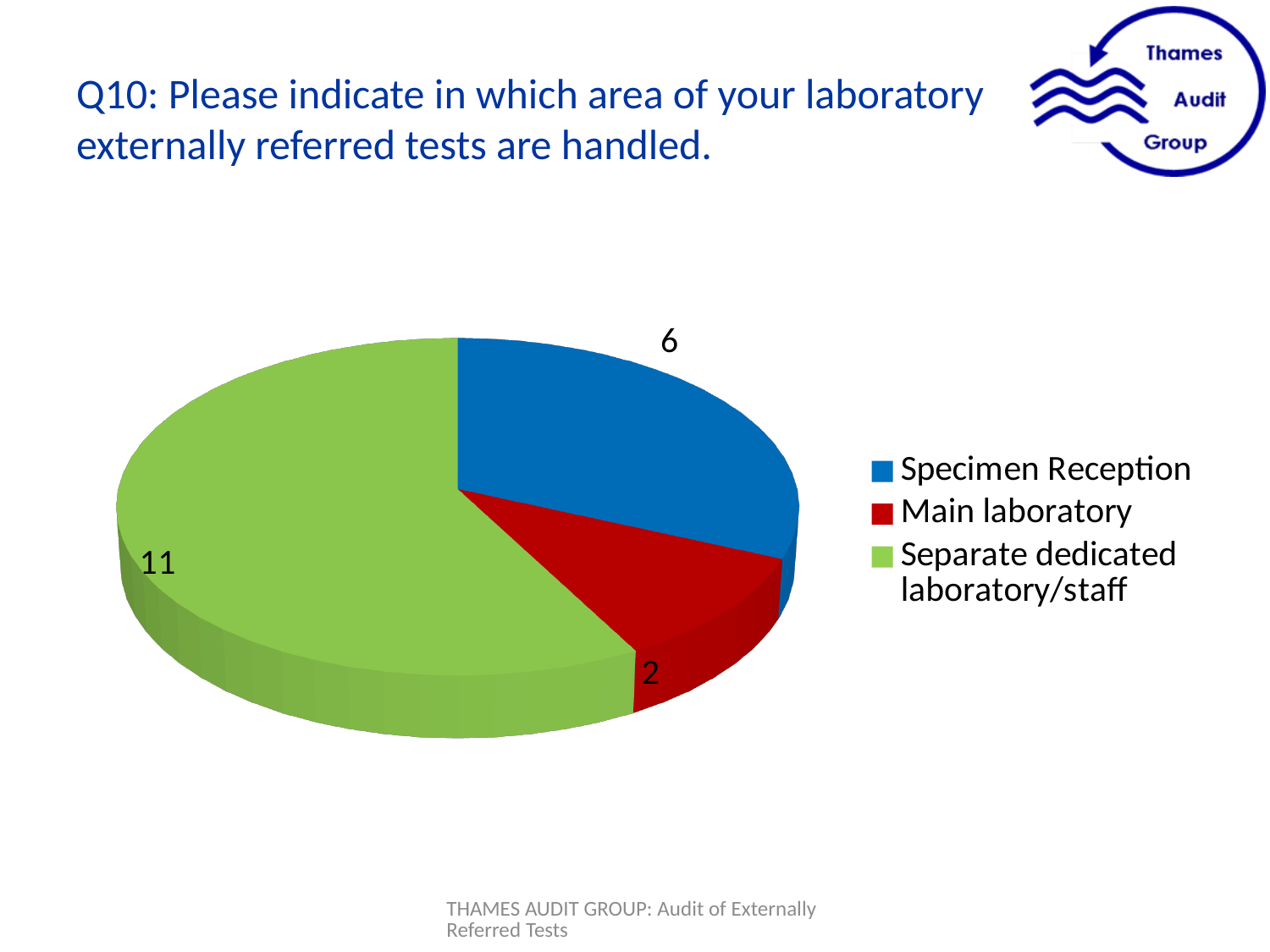
Which category has the smallest slice? Main laboratory What is the difference between the values for Separate dedicated laboratory/staff and Specimen Reception? 5 Which is larger, Specimen Reception or Main laboratory? Specimen Reception What colour is the slice for Main laboratory? red What is the value for Main laboratory? 2 Which category has the largest slice? Separate dedicated laboratory/staff What is the difference between the values for Specimen Reception and Main laboratory? 4 What is the value for Separate dedicated laboratory/staff? 11 How many categories does the pie chart have? 3 What is the value for Specimen Reception? 6 What kind of chart is shown on the slide? pie chart What is the total of all slices in the pie chart? 19